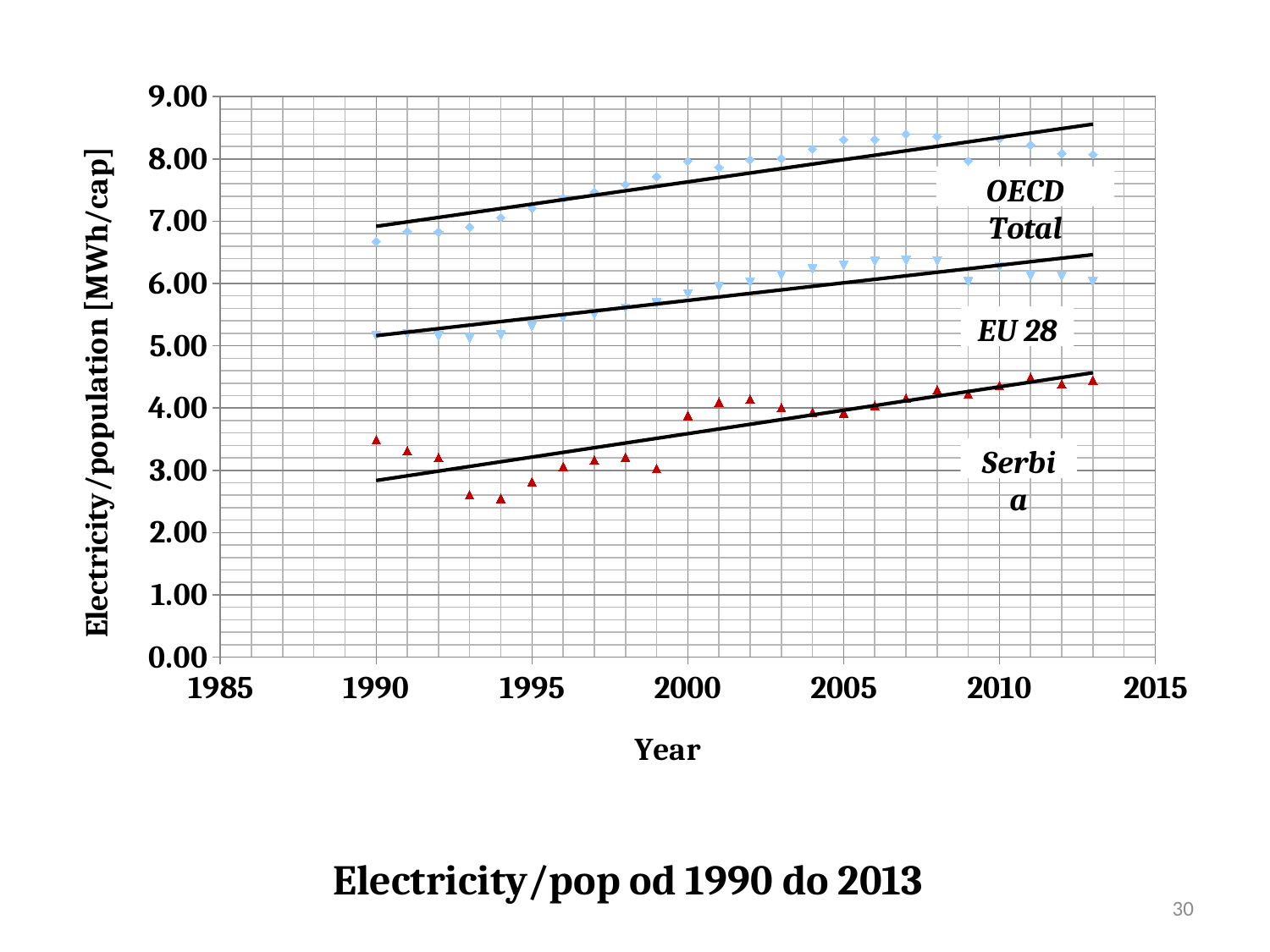
Which series has the highest electricity per population values throughout the chart? OECD Total Is the value for Serbia in 1994 greater or less than 3.00? less In 2000, which is larger: the value for OECD Total or the value for Serbia? OECD Total How many data series are plotted on the chart? 3 Does the trend line for Serbia rise or fall from 1990 to 2013? rise What kind of chart is shown on the slide? scatter chart What is the label of the vertical axis? Electricity/population [MWh/cap] Is the value for EU 28 in 2007 greater or less than 6.00? greater Is the value for Serbia in 2011 greater or less than 4.00? greater Which series has the lowest electricity per population values throughout the chart? Serbia